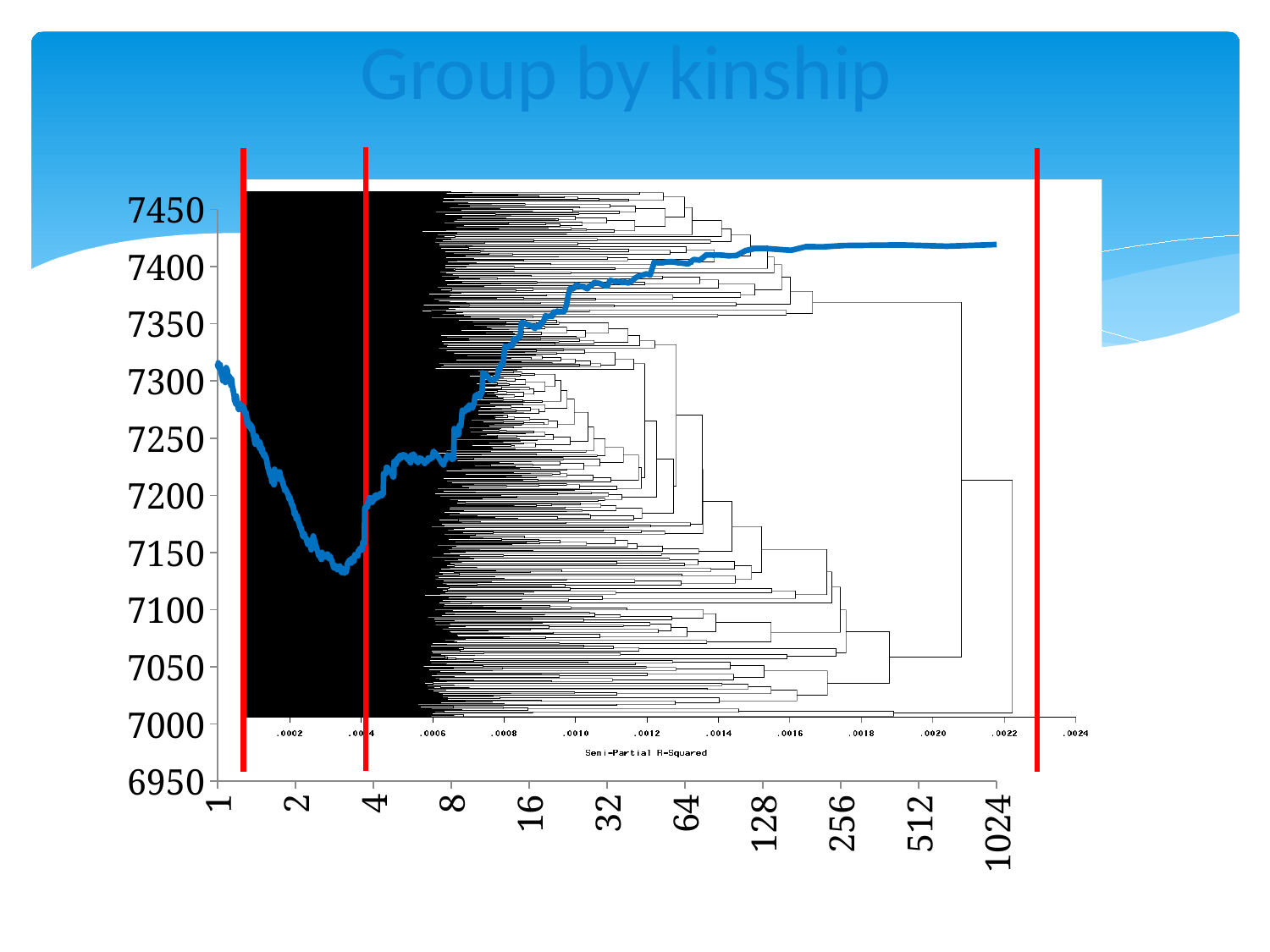
Moving from x = 8 to x = 1024, does the blue line rise or fall? rise What kind of chart is the blue plotted series on this slide? line chart Is the value of the blue line at x = 16 greater or less than 7300? greater Is the value of the blue line at x = 1024 greater or less than 7400? greater Which is larger: the value of the blue line at x = 4 or at x = 32? x = 32 How many tick labels are shown on the x axis (1 through 1024)? 11 Is the lowest point of the blue line greater or less than 7150? less What is the largest value labelled on the x axis? 1024 What is the title of the slide? Group by kinship Which is larger: the value of the blue line at x = 1 or at x = 1024? x = 1024